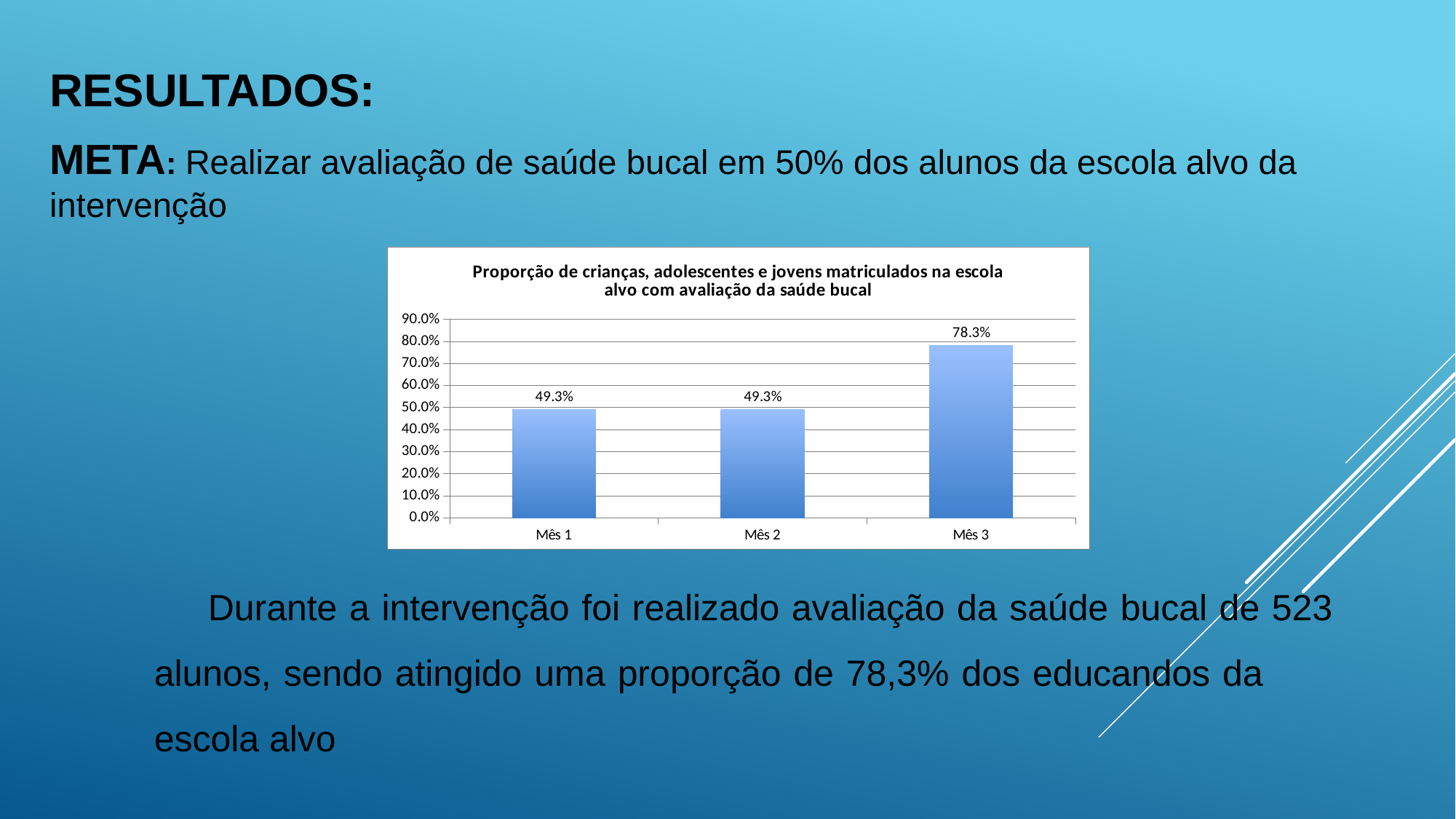
What is the difference between the values for Mês 3 and Mês 2? 29.0% Is the value for Mês 2 greater or less than 50.0%? less How many months are shown on the x axis? 3 What is the title of the chart? Proporção de crianças, adolescentes e jovens matriculados na escola alvo com avaliação da saúde bucal Do Mês 1 and Mês 2 have the same value? Yes What is the value for Mês 1? 49.3% Is the value for Mês 3 greater or less than 70.0%? greater Which month has the highest value? Mês 3 Do the values rise or fall from Mês 2 to Mês 3? rise Which is larger, the value for Mês 1 or the value for Mês 3? Mês 3 What kind of chart is shown on the slide? bar chart What is the value for Mês 3? 78.3%